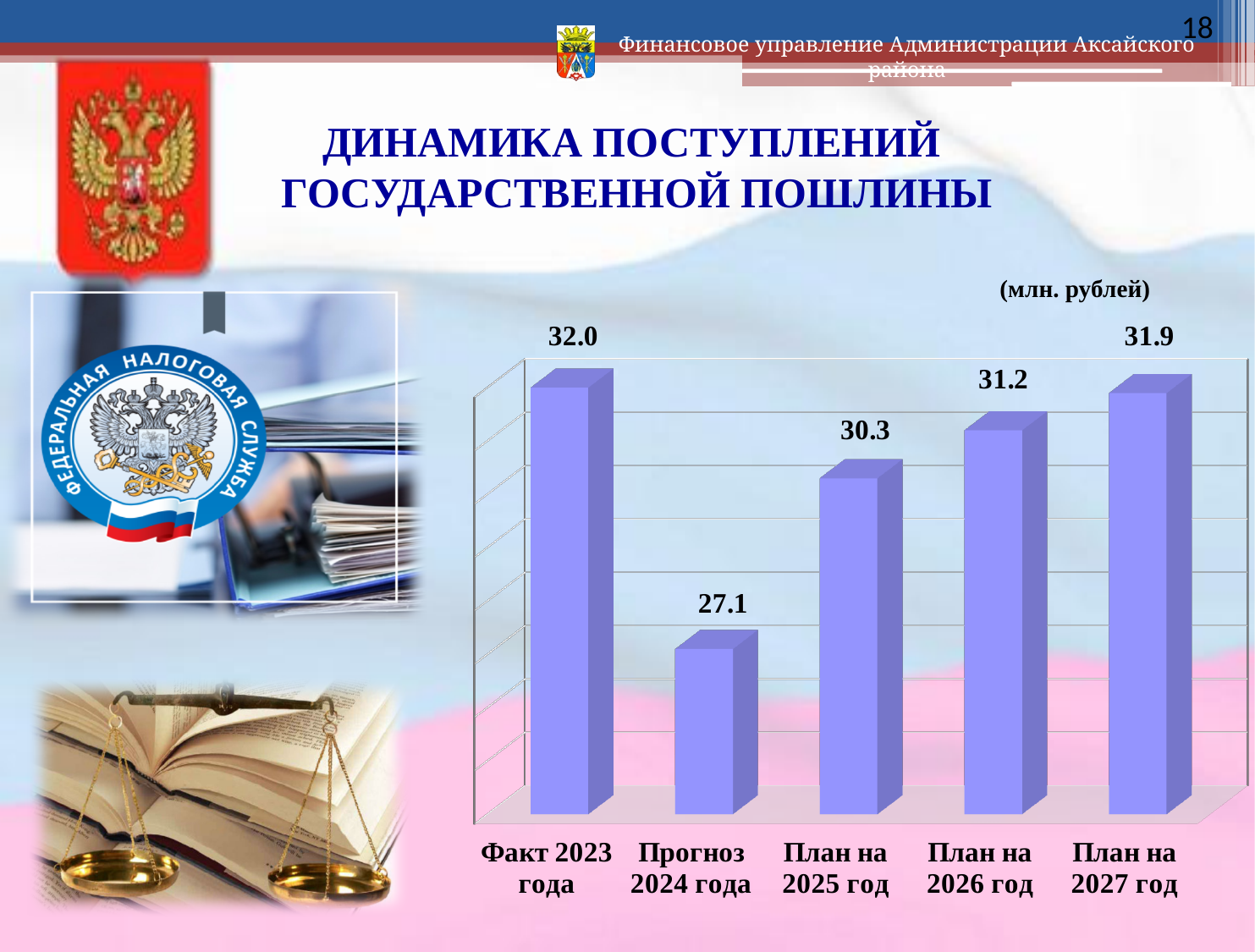
Which is larger, the value for План на 2026 год or the value for План на 2025 год? План на 2026 год What is the value for Факт 2023 года? 32.0 What kind of chart is shown on the slide? Bar chart What is the value for План на 2027 год? 31.9 What is the value for Прогноз 2024 года? 27.1 What is the value for План на 2025 год? 30.3 What unit is indicated for the values in the chart? млн. рублей Which category has the highest value? Факт 2023 года What is the difference between the values for Факт 2023 года and Прогноз 2024 года? 4.9 How many categories are shown in the chart? 5 Which category has the lowest value? Прогноз 2024 года What is the difference between the values for План на 2027 год and План на 2026 год? 0.7